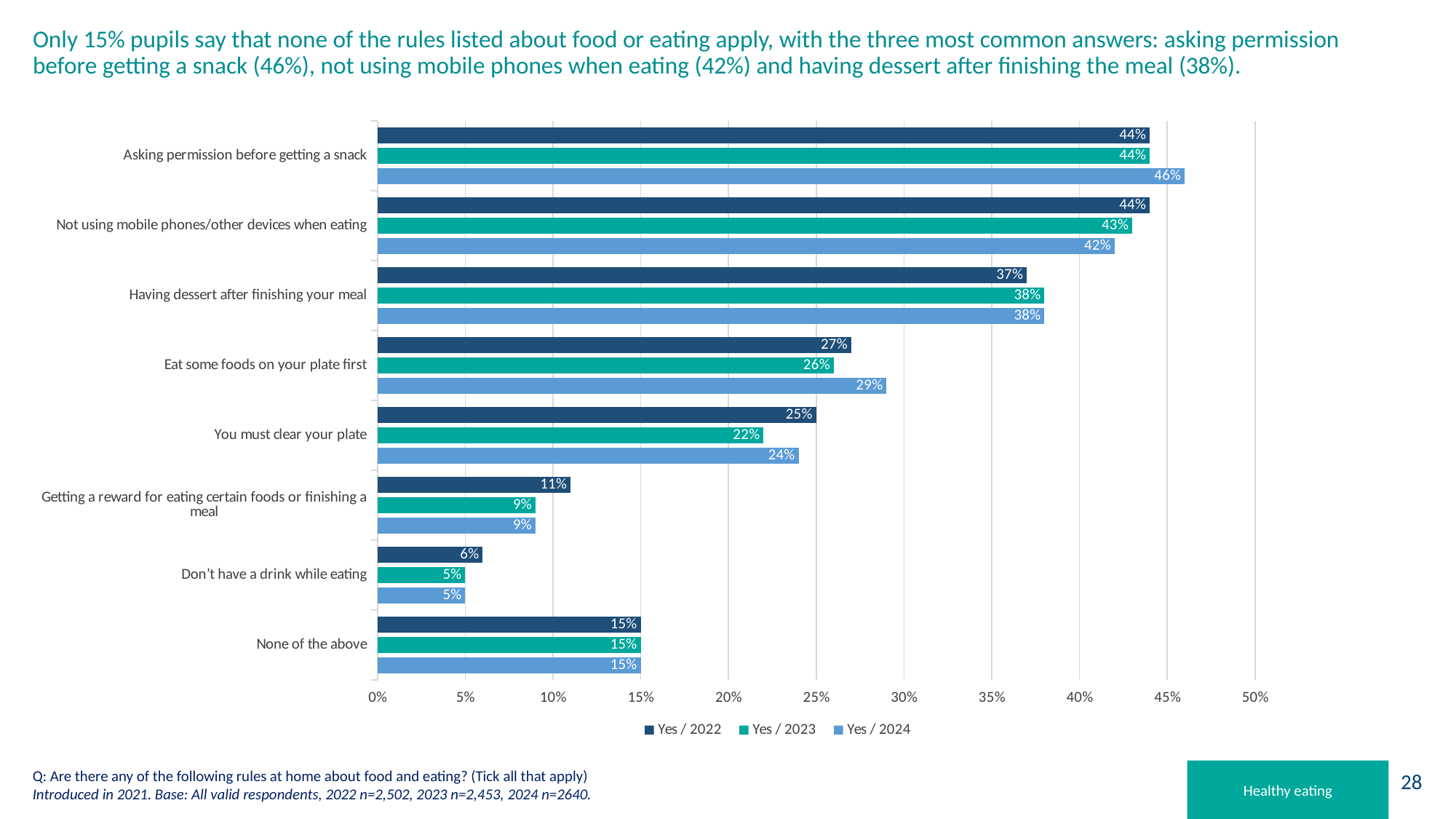
What is the value for 'Getting a reward for eating certain foods or finishing a meal' in the Yes / 2022 series? 11% What is the value for 'None of the above' in the Yes / 2022 series? 15% How many series does the legend list? 3 Is the Yes / 2023 value for 'Having dessert after finishing your meal' greater or less than 35%? greater What is the value for 'You must clear your plate' in the Yes / 2023 series? 22% What kind of chart is shown on the slide? Bar chart What is the difference between the Yes / 2024 and Yes / 2022 values for 'Eat some foods on your plate first'? 2% For 'Not using mobile phones/other devices when eating', which is larger: the Yes / 2022 value or the Yes / 2024 value? Yes / 2022 How many categories are shown on the chart? 8 What is the value for 'Asking permission before getting a snack' in the Yes / 2024 series? 46% Which category has the lowest value in the Yes / 2024 series? Don't have a drink while eating Which category has the highest value in the Yes / 2024 series? Asking permission before getting a snack